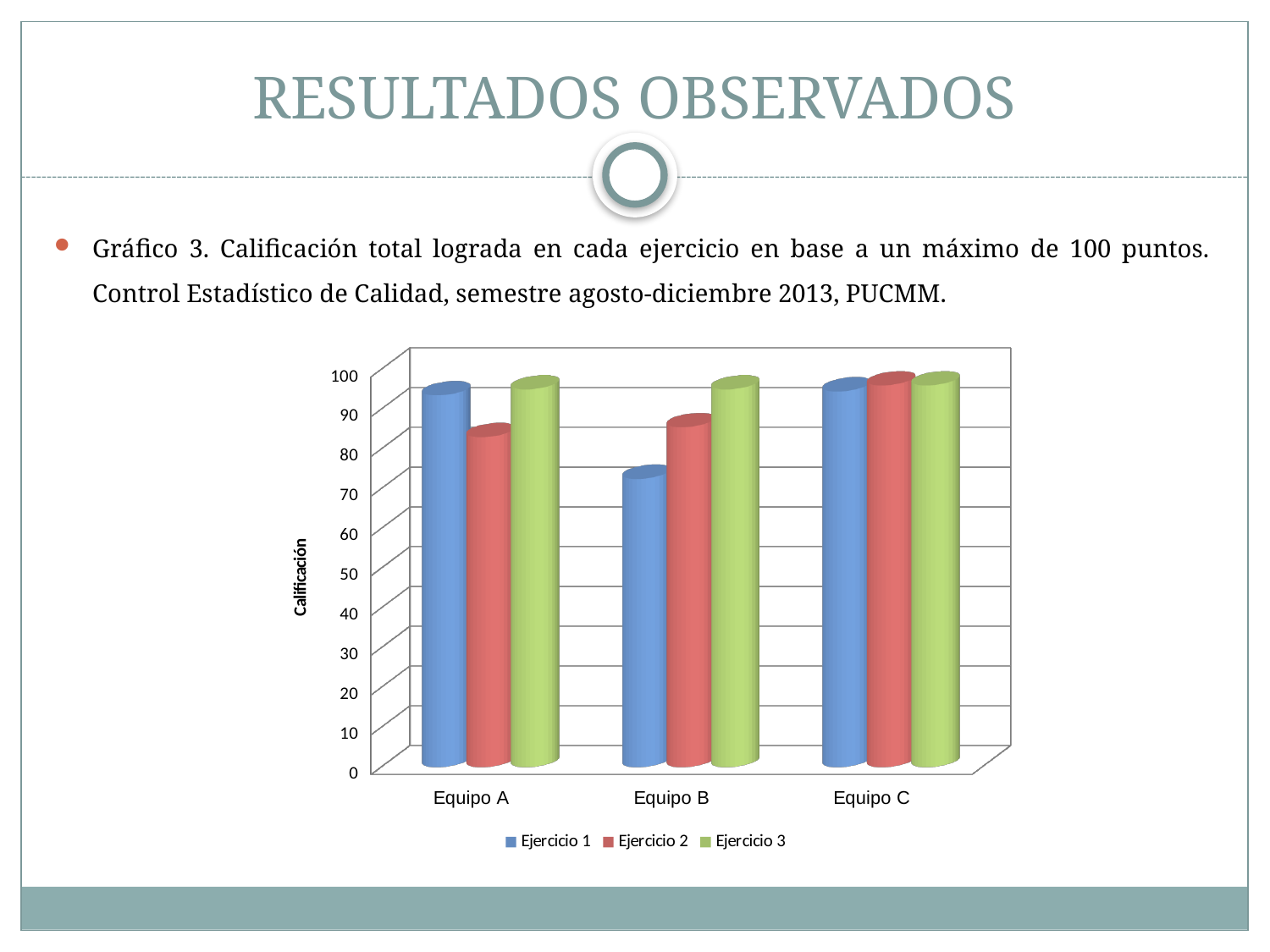
What is the title of the vertical axis of the chart? Calificación Is the value for Ejercicio 2 for Equipo B greater or less than 90? less For Equipo A, which is larger: Ejercicio 1 or Ejercicio 2? Ejercicio 1 Which team has the lowest value for Ejercicio 1? Equipo B For Equipo B, which is larger: Ejercicio 1 or Ejercicio 3? Ejercicio 3 Is the value for Ejercicio 1 for Equipo A greater or less than 90? greater How many series does the legend list? 3 For Equipo A, which exercise has the lowest value? Ejercicio 2 Is the value for Ejercicio 1 for Equipo B greater or less than 80? less How many teams (categories) are shown on the x axis? 3 What kind of chart is shown on the slide? bar chart